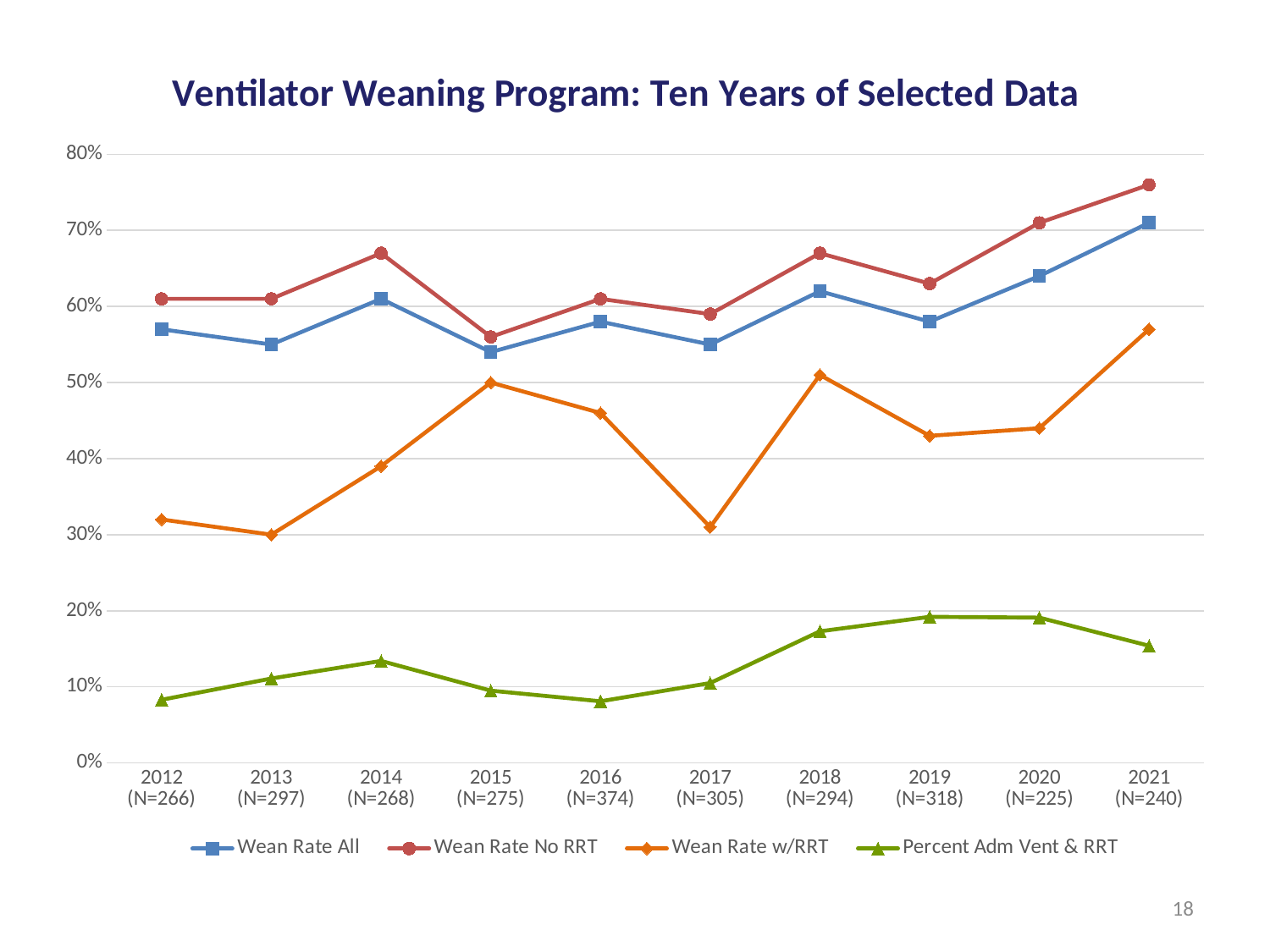
Which is larger in 2018: Wean Rate No RRT or Wean Rate w/RRT? Wean Rate No RRT Does the Wean Rate No RRT series rise or fall from 2019 to 2021? rise What is the title of the chart? Ventilator Weaning Program: Ten Years of Selected Data In which year is the Wean Rate No RRT series at its highest? 2021 (N=240) Is the value for Wean Rate w/RRT in 2017 greater or less than 40%? less In which year is the Wean Rate w/RRT series at its lowest? 2013 (N=297) How many years are plotted along the x axis? 10 Is the value for Wean Rate No RRT in 2021 greater or less than 70%? greater Is the value for Percent Adm Vent & RRT in 2019 greater or less than 10%? greater What kind of chart is shown on the slide? line chart How many series does the legend list? 4 In which year is the Wean Rate All series at its lowest? 2015 (N=275)